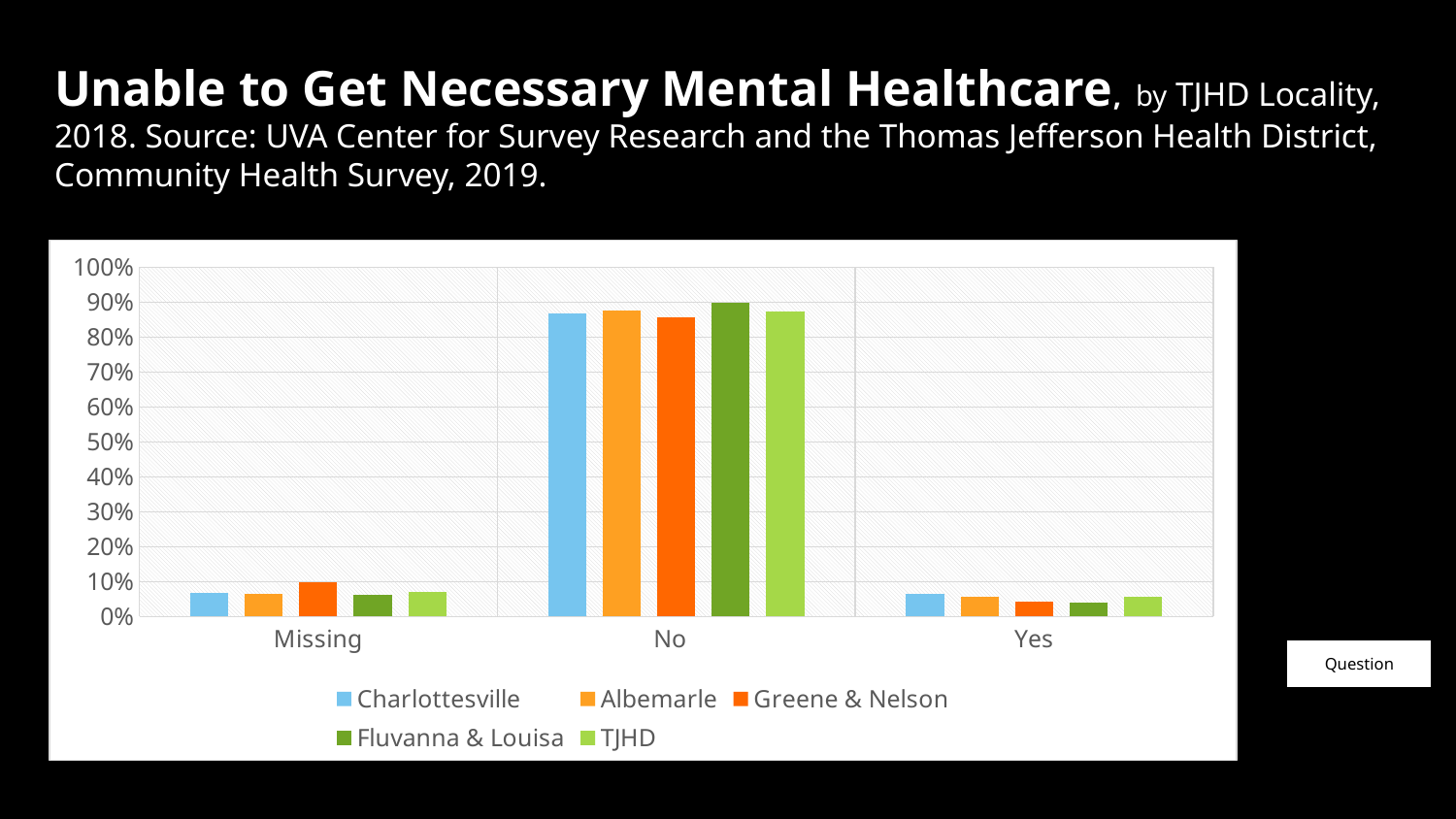
Is the value for Fluvanna & Louisa in the Yes category greater or less than 10%? less For Albemarle, which is larger: the No value or the Yes value? No For Greene & Nelson, which is larger: the Missing value or the Yes value? Missing What kind of chart is shown on the slide? bar chart Is the value for TJHD in the No category greater or less than 50%? greater How many series does the legend list? 5 Within the Missing category, which locality has the highest value? Greene & Nelson Is the value for Greene & Nelson in the Missing category greater or less than 5%? greater Which locality is shown in light blue in the legend? Charlottesville How many categories are shown on the x axis? 3 Which category has the tallest bars for every locality? No